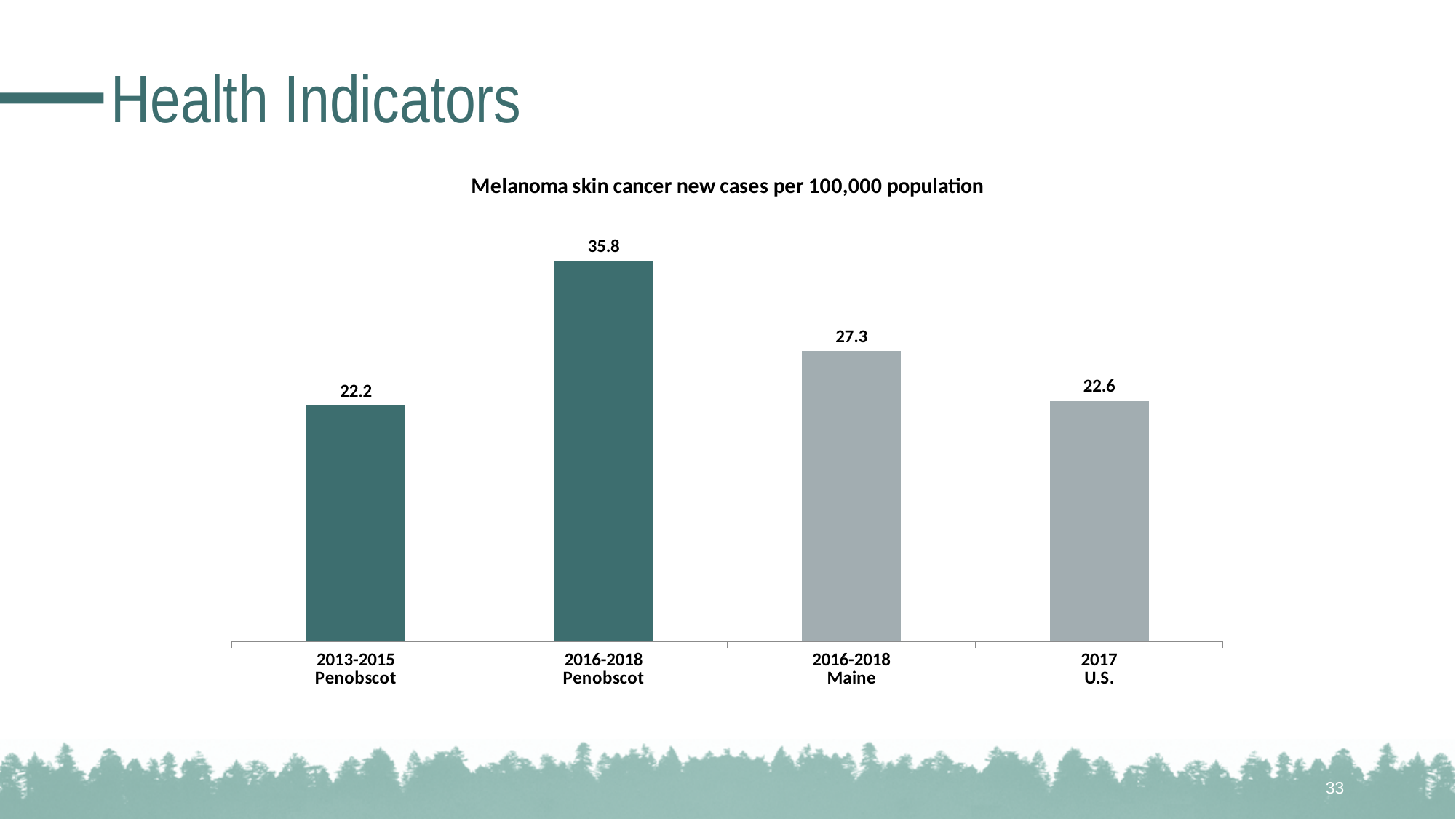
What is the value for 2016-2018 Penobscot? 35.8 What is the value for 2017 U.S.? 22.6 What is the title of the chart? Melanoma skin cancer new cases per 100,000 population What is the difference between the 2016-2018 Maine value and the 2017 U.S. value? 4.7 What is the value for 2013-2015 Penobscot? 22.2 Which category has the highest value? 2016-2018 Penobscot Which is larger, the value for 2016-2018 Maine or the value for 2017 U.S.? 2016-2018 Maine What is the value for 2016-2018 Maine? 27.3 How many bars are shown in the chart? 4 Which category has the lowest value? 2013-2015 Penobscot What kind of chart is shown on the slide? Bar chart What is the difference between the 2016-2018 Penobscot value and the 2013-2015 Penobscot value? 13.6